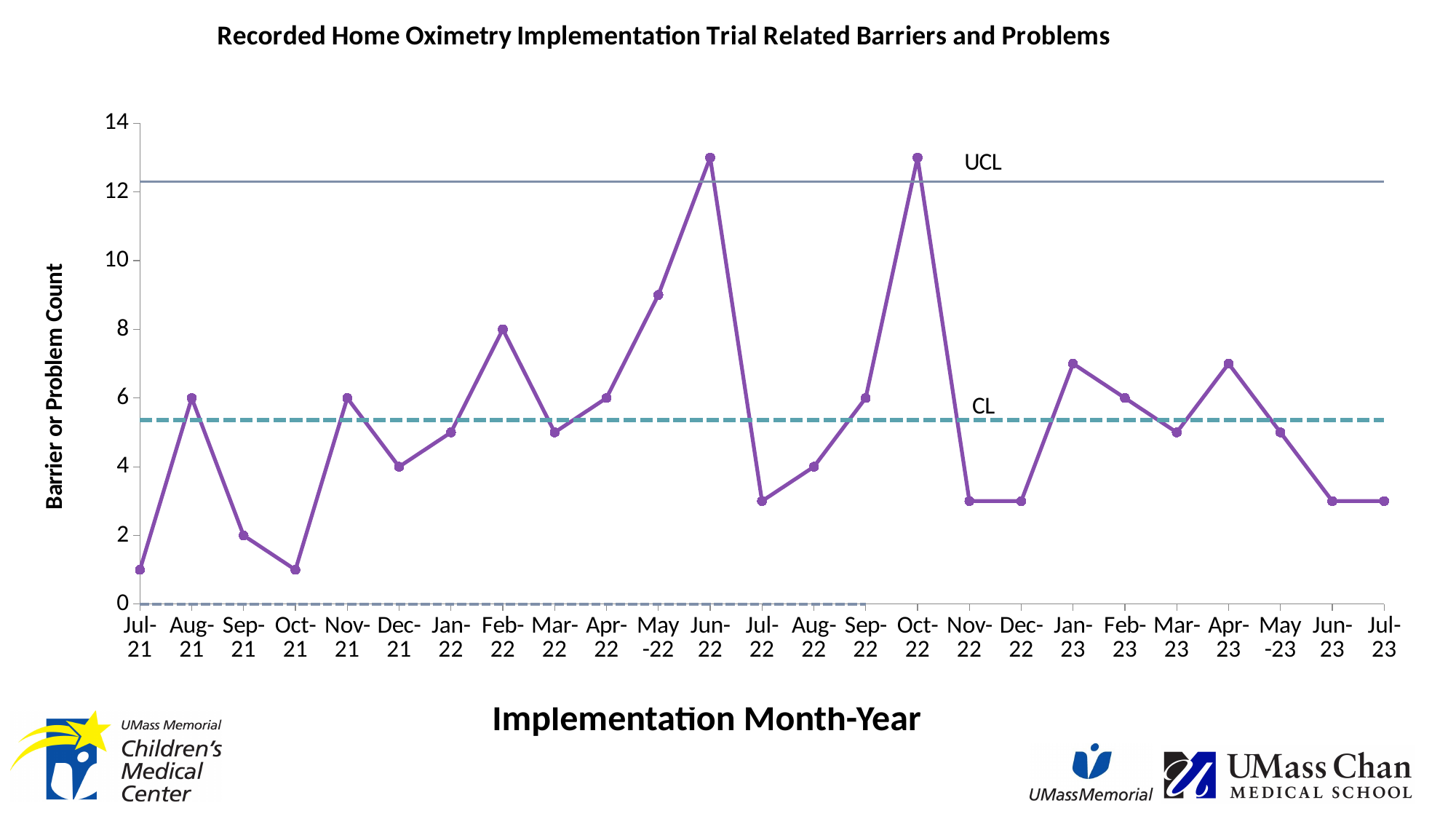
Which has a larger value, Jun-22 or Jul-22? Jun-22 What is the difference between the values for Feb-22 and Dec-21? 4 What kind of chart is shown on the slide? line chart What is the barrier or problem count for Feb-22? 8 What is the barrier or problem count for Dec-21? 4 What is the barrier or problem count for Sep-21? 2 Is the value for Nov-22 greater or less than 4? less Is the value for Jun-22 greater or less than 12? greater What is the title of the chart? Recorded Home Oximetry Implementation Trial Related Barriers and Problems How many monthly data points are plotted on the chart? 25 What is the label of the y axis? Barrier or Problem Count What is the barrier or problem count for Aug-21? 6